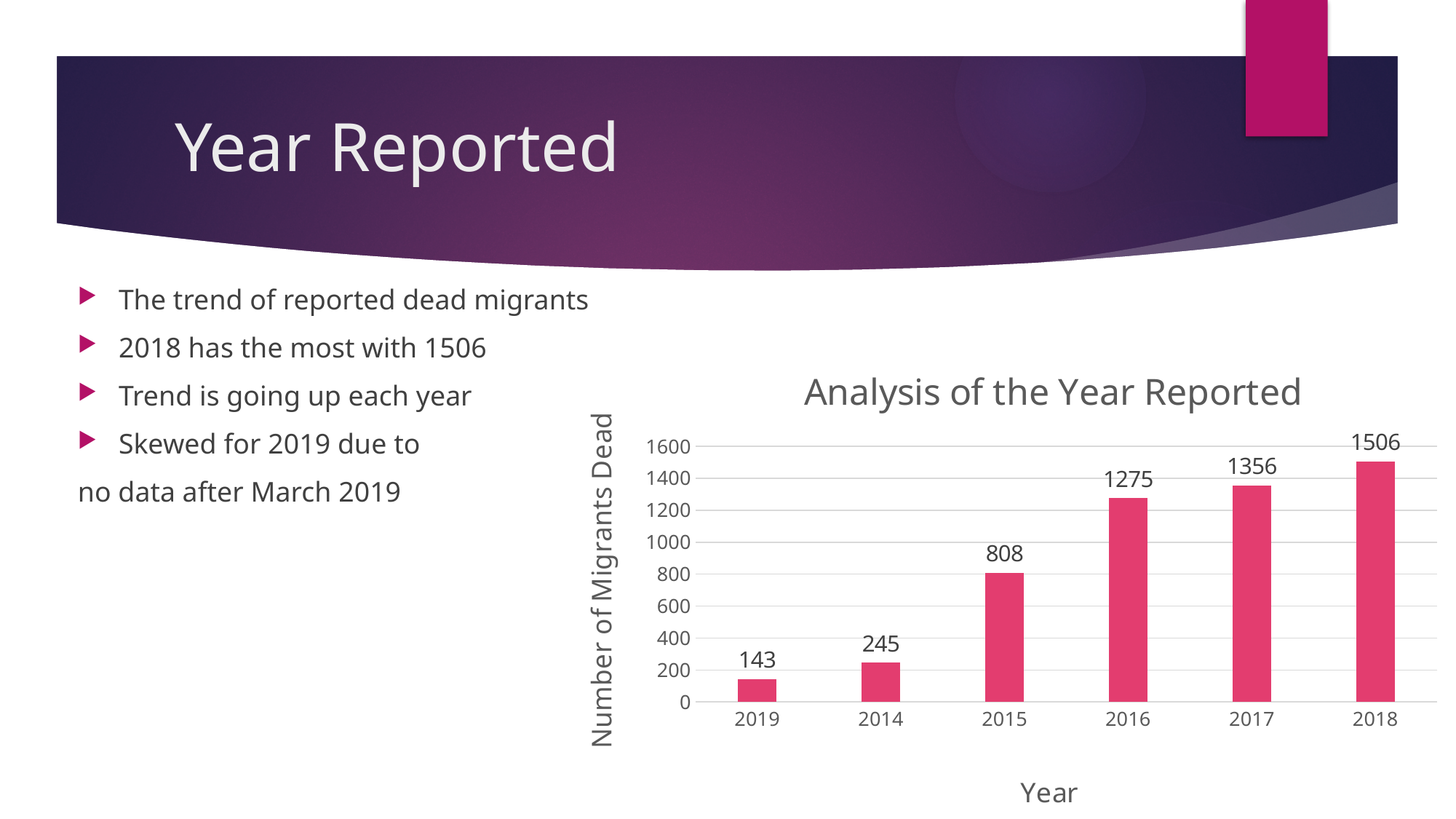
What is the number of migrants dead for 2019? 143 Which is larger, the value for 2014 or the value for 2019? 2014 What is the title of the chart? Analysis of the Year Reported Which year has the highest number of migrants dead? 2018 How many years are shown on the x axis? 6 What is the difference between the values for 2018 and 2017? 150 What is the difference between the values for 2016 and 2015? 467 Which year has the lowest number of migrants dead? 2019 What kind of chart is shown on the slide? Bar chart What is the number of migrants dead for 2018? 1506 What is the number of migrants dead for 2015? 808 Is the value for 2016 greater or less than 1200? greater